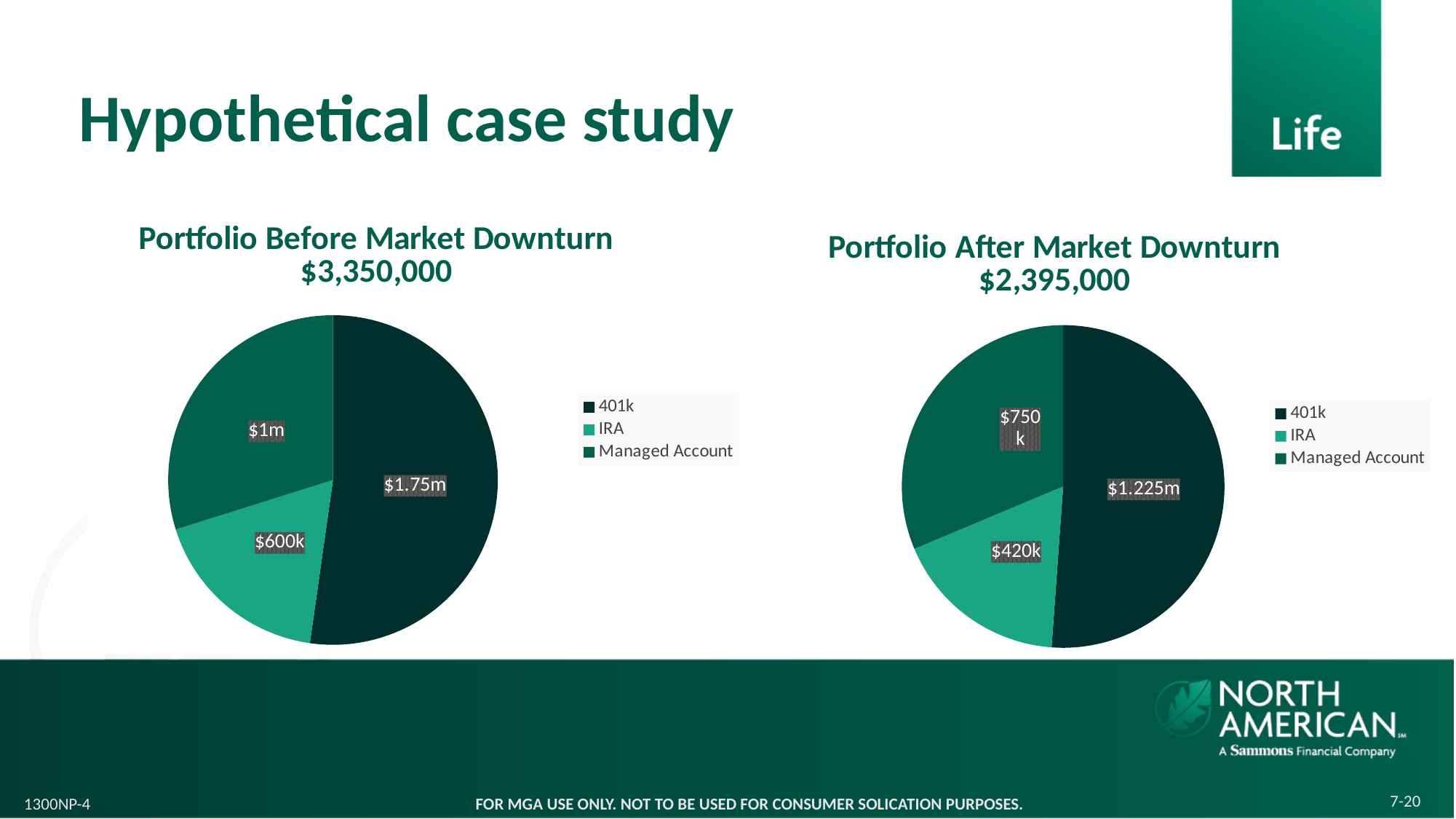
In the Portfolio Before Market Downturn chart, which category has the largest slice? 401k In the Portfolio After Market Downturn chart, what is the difference between the Managed Account and IRA values? $330k In the Portfolio After Market Downturn chart, what is the value of the Managed Account slice? $750k In the Portfolio Before Market Downturn chart, what is the value of the 401k slice? $1.75m What kind of chart is the Portfolio After Market Downturn chart? Pie chart In the Portfolio Before Market Downturn chart, what is the value of the IRA slice? $600k In the Portfolio After Market Downturn chart, which is larger, the IRA slice or the Managed Account slice? Managed Account In the Portfolio After Market Downturn chart, what is the value of the 401k slice? $1.225m How many slices does the Portfolio Before Market Downturn chart have? 3 In the Portfolio After Market Downturn chart, which category has the smallest slice? IRA What total value is shown under the title of the Portfolio After Market Downturn chart? $2,395,000 In the Portfolio Before Market Downturn chart, what is the difference between the Managed Account and IRA values? $400k